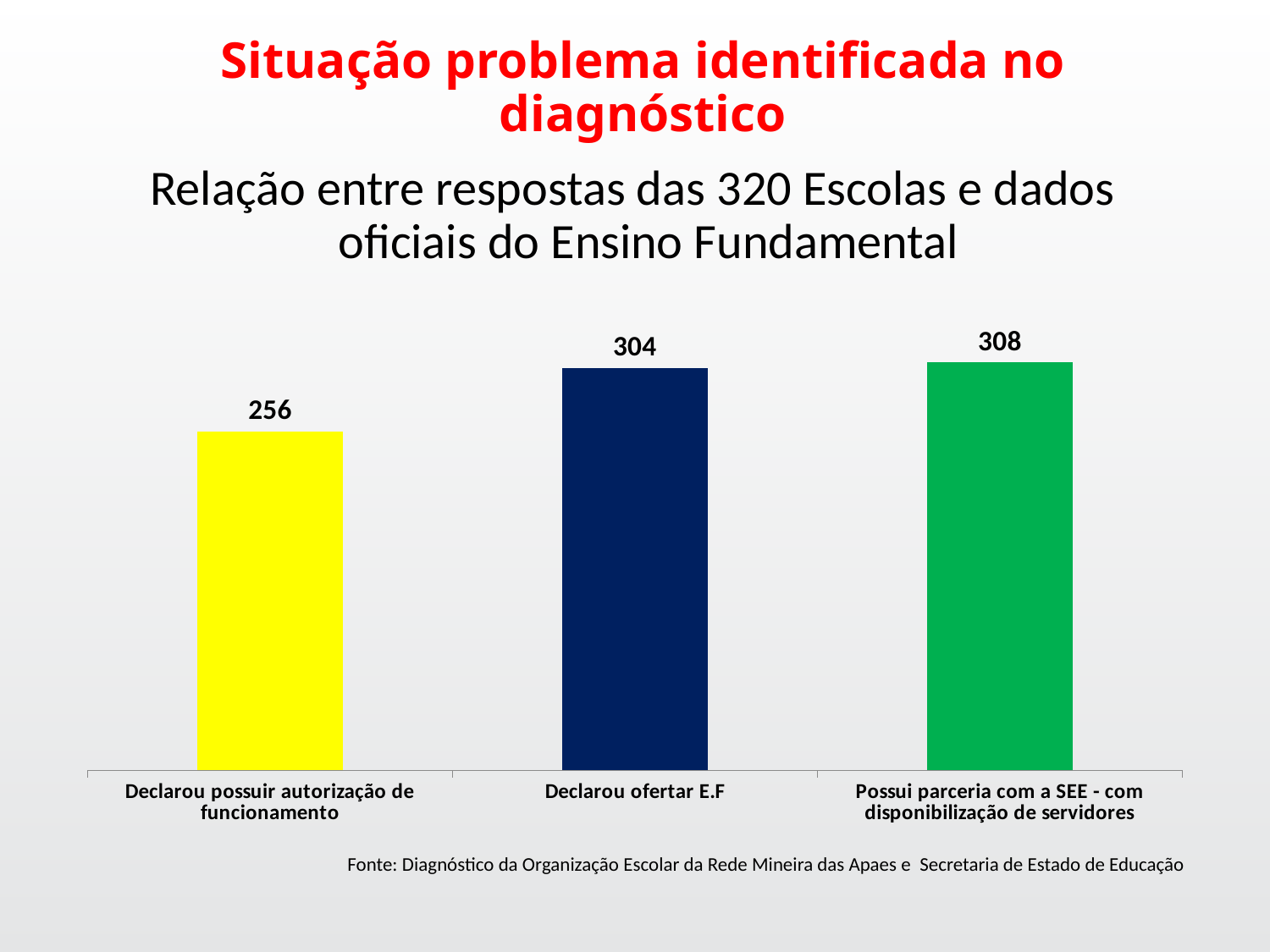
What is the difference between the values for "Declarou ofertar E.F" and "Declarou possuir autorização de funcionamento"? 48 What is the value for "Declarou ofertar E.F"? 304 How many categories are shown in the chart? 3 What is the value for "Possui parceria com a SEE - com disponibilização de servidores"? 308 Which category has the lowest value? Declarou possuir autorização de funcionamento What is the difference between the values for "Possui parceria com a SEE - com disponibilização de servidores" and "Declarou ofertar E.F"? 4 What is the value for "Declarou possuir autorização de funcionamento"? 256 Which is larger: the value for "Declarou ofertar E.F" or the value for "Declarou possuir autorização de funcionamento"? Declarou ofertar E.F What colour is the bar for "Declarou possuir autorização de funcionamento"? Yellow What colour is the bar for "Declarou ofertar E.F"? Dark blue What kind of chart is shown on the slide? Bar chart Which category has the highest value? Possui parceria com a SEE - com disponibilização de servidores